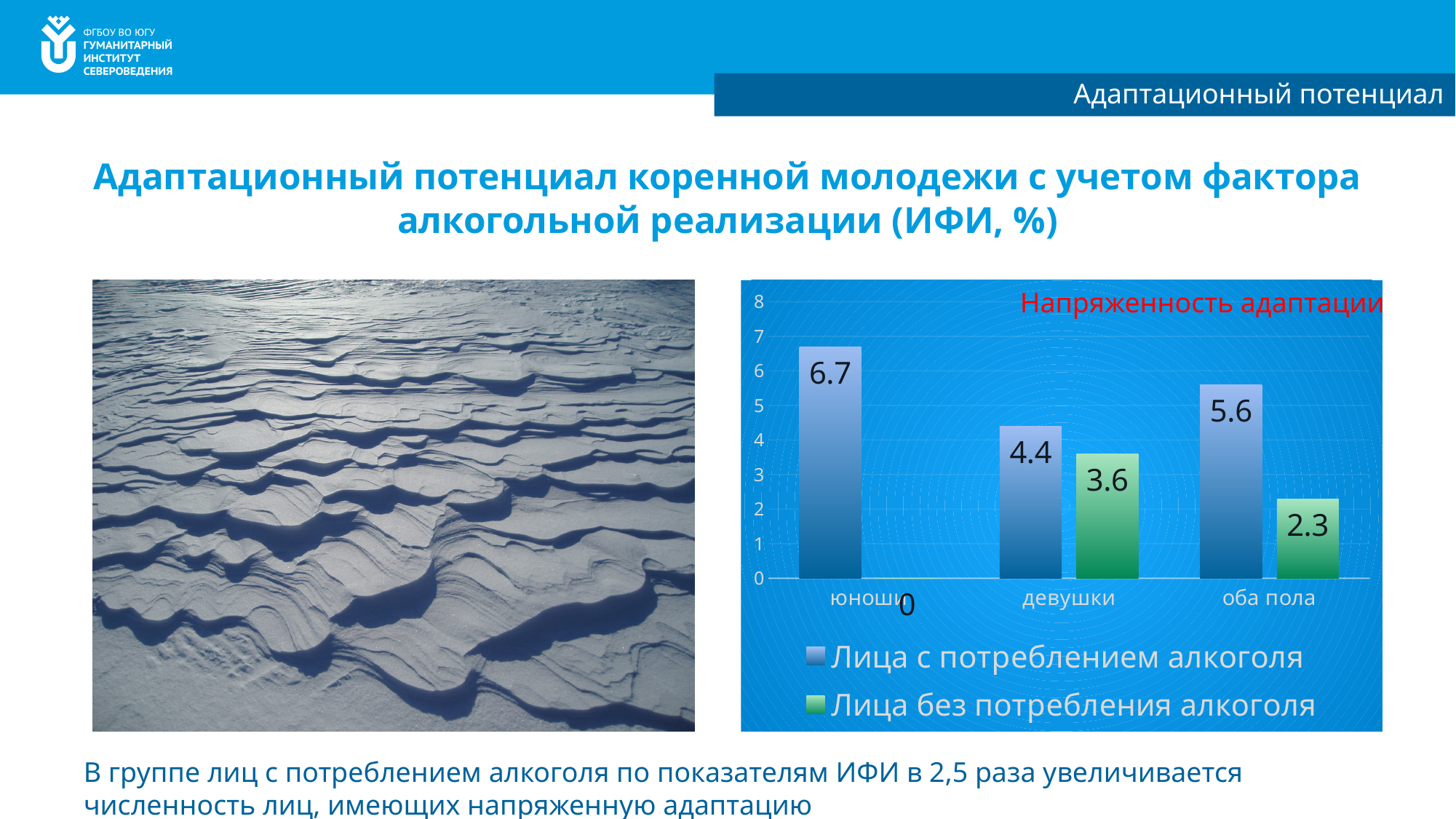
Which is larger for оба пола: the value for Лица с потреблением алкоголя or for Лица без потребления алкоголя? Лица с потреблением алкоголя What is the value for юноши in the series Лица с потреблением алкоголя? 6.7 Which category has the highest value in the series Лица с потреблением алкоголя? юноши What title is shown inside the chart area in red text? Напряженность адаптации What is the value for девушки in the series Лица без потребления алкоголя? 3.6 How many categories are shown on the x axis? 3 What is the value for оба пола in the series Лица с потреблением алкоголя? 5.6 What is the difference between the values for девушки in the two series (Лица с потреблением алкоголя minus Лица без потребления алкоголя)? 0.8 How many series does the legend list? 2 What type of chart is shown on the slide? bar chart What is the value for оба пола in the series Лица без потребления алкоголя? 2.3 Which category has the lowest value in the series Лица с потреблением алкоголя? девушки